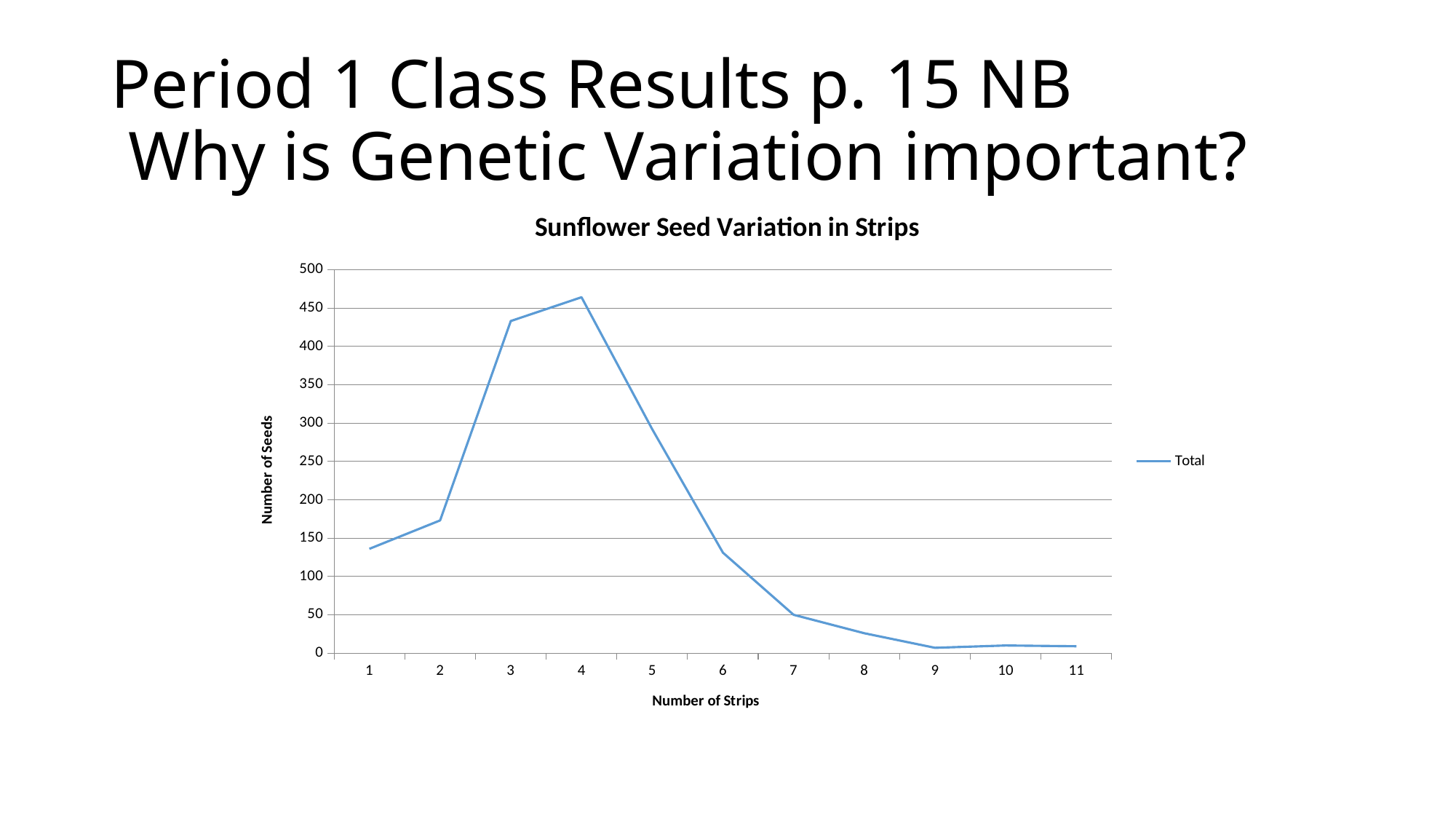
Is the value for 7 strips greater or less than 100? less How many strip categories are plotted along the x axis? 11 Which number of strips has the highest number of seeds? 4 Is the value for 3 strips greater or less than 400? greater Is the value for 1 strip greater or less than 150? less Which has a larger number of seeds, 3 strips or 6 strips? 3 strips What kind of chart is shown on the slide? line chart What is the title of the chart? Sunflower Seed Variation in Strips How many series does the legend list? 1 What is the name of the series shown in the legend? Total Do the values rise or fall from 4 strips to 9 strips? fall